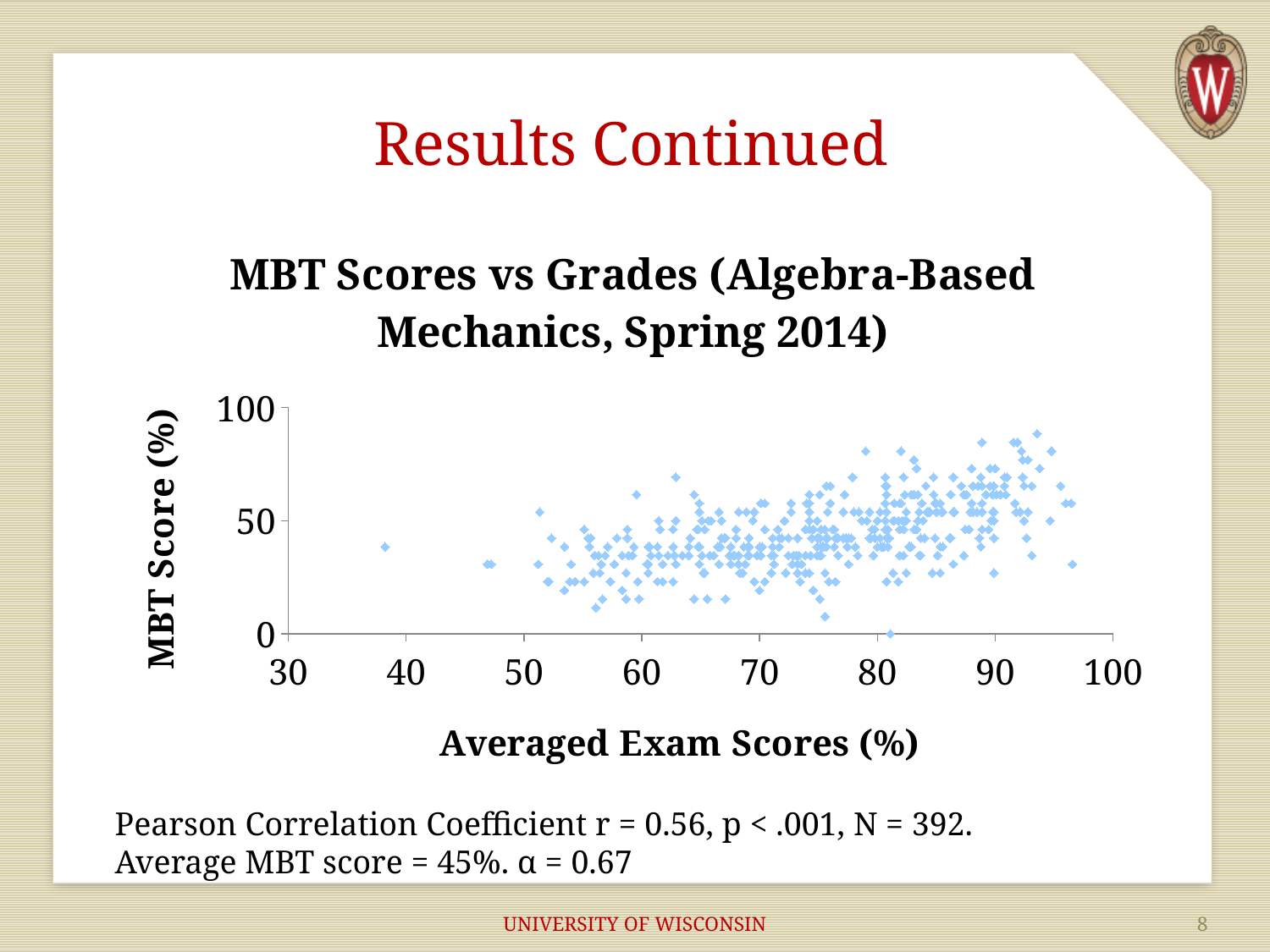
Is the averaged exam score of the rightmost point greater or less than 90? greater What is the label of the x axis of the chart? Averaged Exam Scores (%) Is the MBT score of the lowest point on the chart (near an averaged exam score of 81) greater or less than 50? less What is the highest value shown on the x axis of the chart? 100 Do MBT scores generally rise or fall as averaged exam scores increase along the x axis? rise Is the MBT score of the leftmost point (near an averaged exam score of 38) greater or less than 50? less What kind of chart is shown on the slide? scatter plot What is the title of the chart? MBT Scores vs Grades (Algebra-Based Mechanics, Spring 2014)